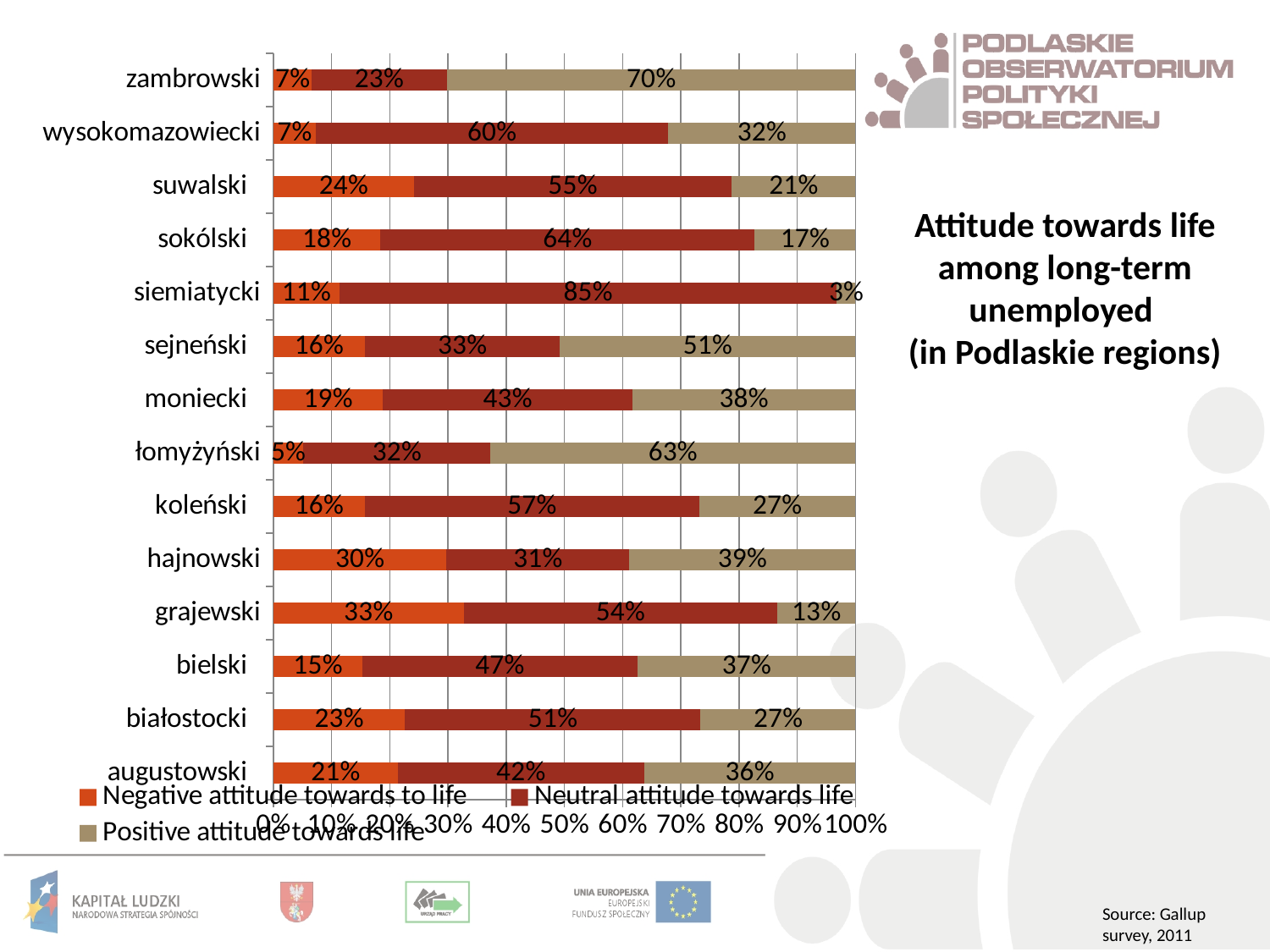
Which region has the highest share of positive attitude towards life? zambrowski What is the difference in percentage points between the positive and negative attitude values for the zambrowski region? 63 percentage points What type of chart is shown on the slide? Stacked bar chart How many regions are shown in the chart? 14 What is the neutral attitude value for the siemiatycki region? 85% What is the negative attitude value for the hajnowski region? 30% What percentage of long-term unemployed in the zambrowski region have a positive attitude towards life? 70% Which region has the highest share of negative attitude towards life? grajewski How many series does the legend list? 3 Which is larger for the sejneński region: the neutral attitude share or the positive attitude share? Positive attitude share Which region has the lowest share of positive attitude towards life? siemiatycki Which region has the lowest share of negative attitude towards life? łomyżyński